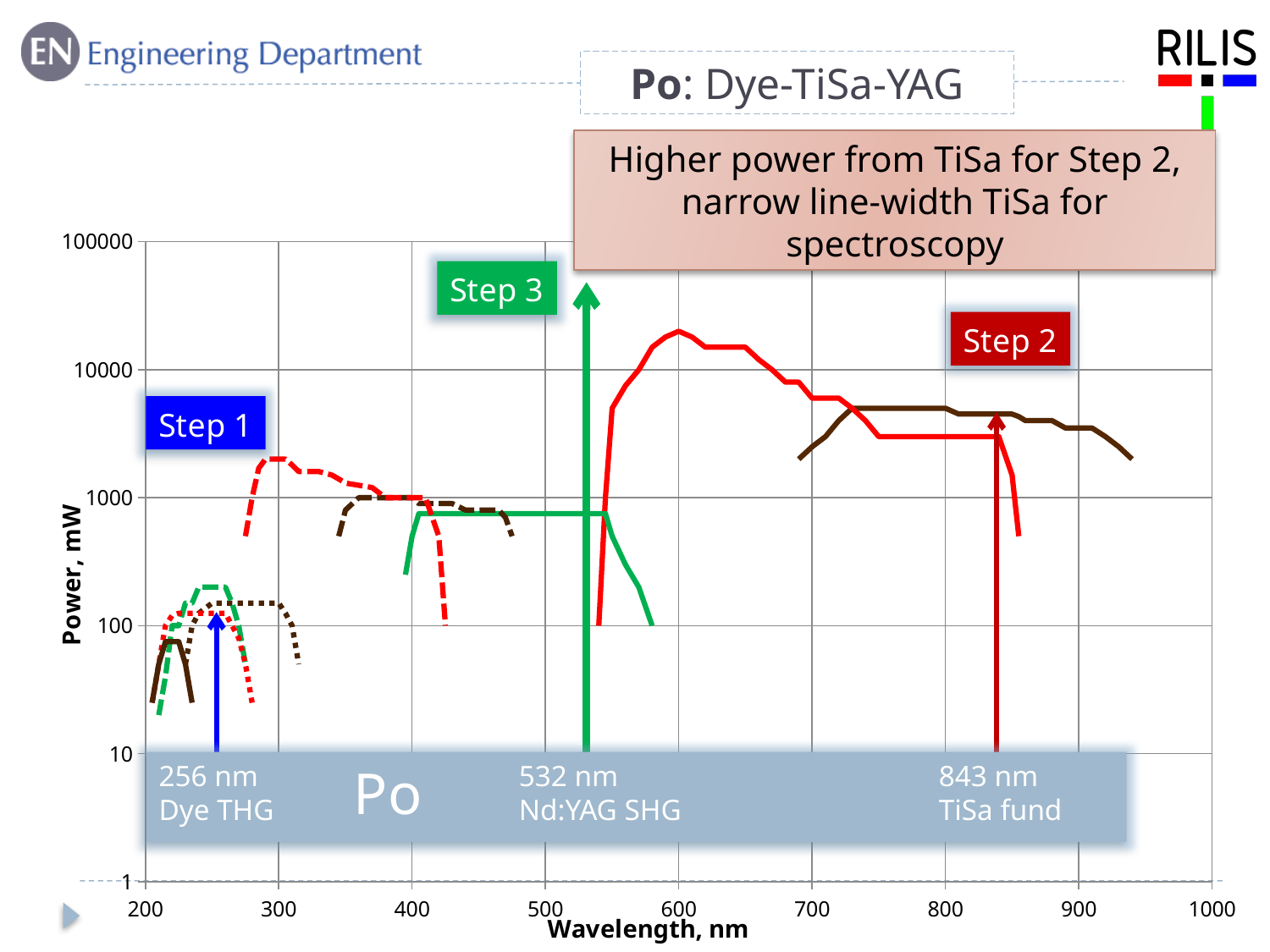
What wavelength is marked for Step 2 on the chart? 843 nm What kind of chart is shown on the slide? line chart Is the power of the solid blue-marked Step 1 point at 256 nm greater or less than 1000 mW? less Which laser source is labelled at 843 nm on the chart? TiSa fund What is the label of the vertical axis of the chart? Power, mW What wavelength is marked for Step 1 on the chart? 256 nm Which laser source is labelled at 532 nm on the chart? Nd:YAG SHG Is the power of the solid green curve between 400 nm and 500 nm greater or less than 1000 mW? less What wavelength is marked for Step 3 on the chart? 532 nm Is the peak power of the solid red curve near 600 nm greater or less than 10000 mW? greater What is the title of the chart on the slide? Po: Dye-TiSa-YAG